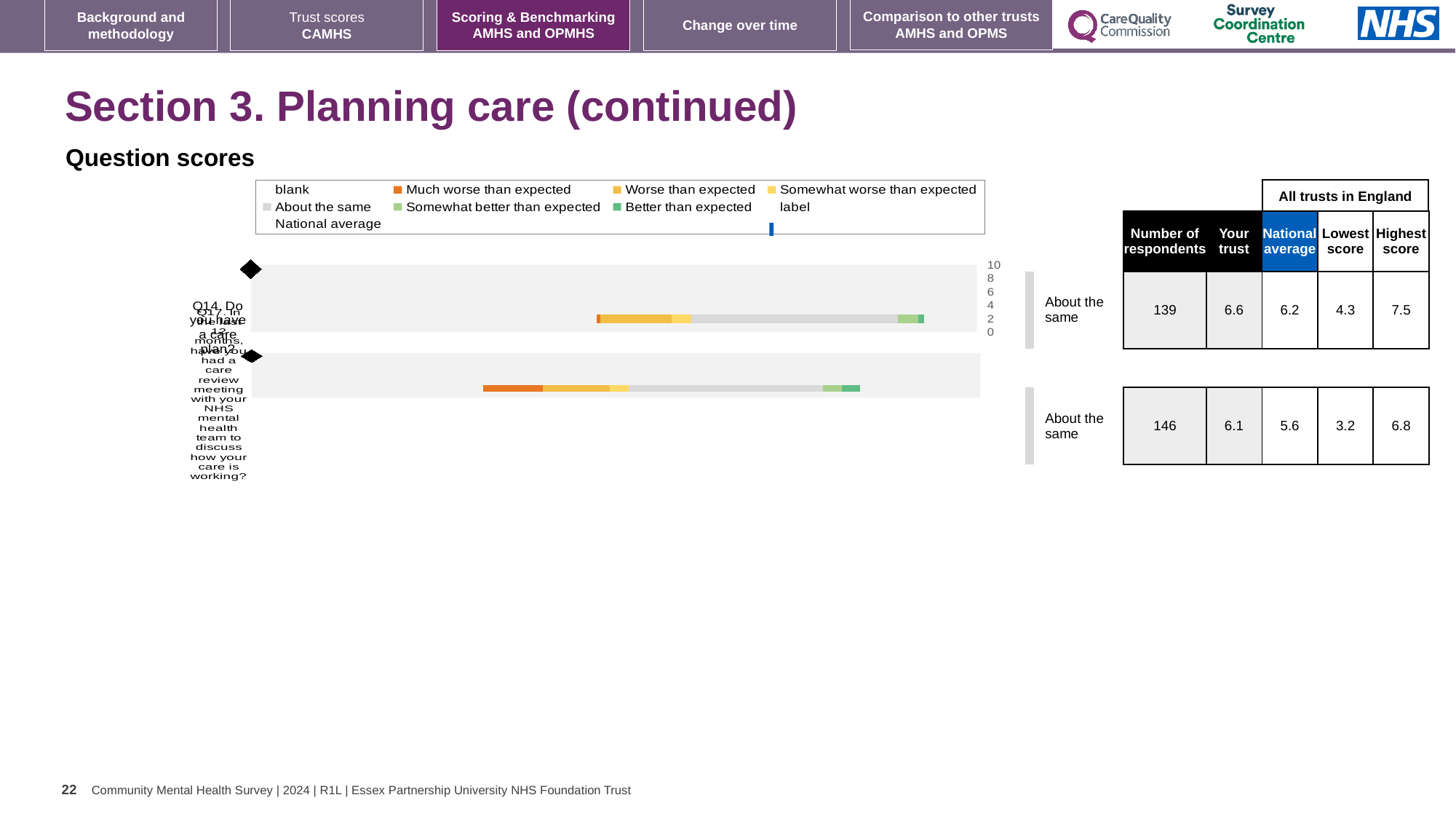
What is the 'Your trust' score for Q17 (care review meeting) in the table? 6.1 What is the highest score across all trusts in England for Q14? 7.5 What is the highest value shown on the chart's score axis? 10 How many questions (bars) are plotted in the chart? 2 What colour does the legend use for 'Much worse than expected'? orange What kind of chart is shown under 'Question scores'? bar chart By how much does the 'Your trust' score for Q14 exceed the national average? 0.4 How many respondents answered Q14 'Do you have a care plan?' according to the table? 139 Which question has the higher 'Your trust' score, Q14 or Q17? Q14 What is the difference between the highest score and the lowest score for Q17? 3.6 For Q14, which is larger: the 'Your trust' score or the 'National average'? Your trust What benchmark category is shown for Q17? About the same